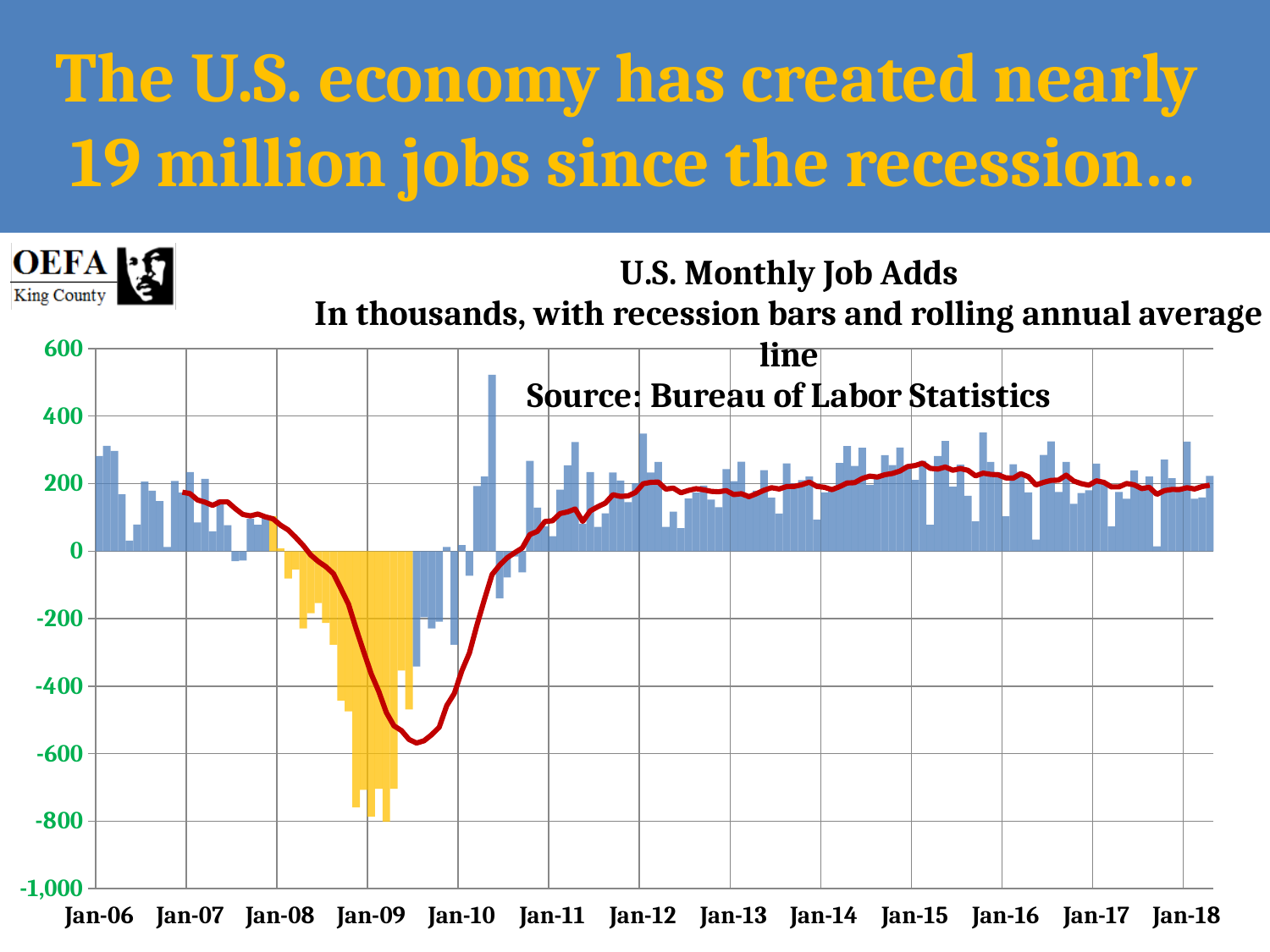
Is the value of the tallest bar on the chart (in 2010) greater or less than 400? greater Does the rolling annual average line rise or fall between Jan-09 and Jan-11? rise How many year labels (Jan-06 through Jan-18) are shown on the x axis? 13 What is the title of the chart? U.S. Monthly Job Adds What kind of chart is shown on the slide? Bar chart with a line overlay Is the rolling annual average line at Jan-15 greater or less than 200? greater Is the lowest point of the rolling annual average line greater or less than -400? less Which is larger: the rolling annual average line at Jan-09 or at Jan-12? Jan-12 According to the chart subtitle, what is the source of the data? Bureau of Labor Statistics Do the monthly job add bars generally rise or fall between Jan-08 and Jan-09? fall